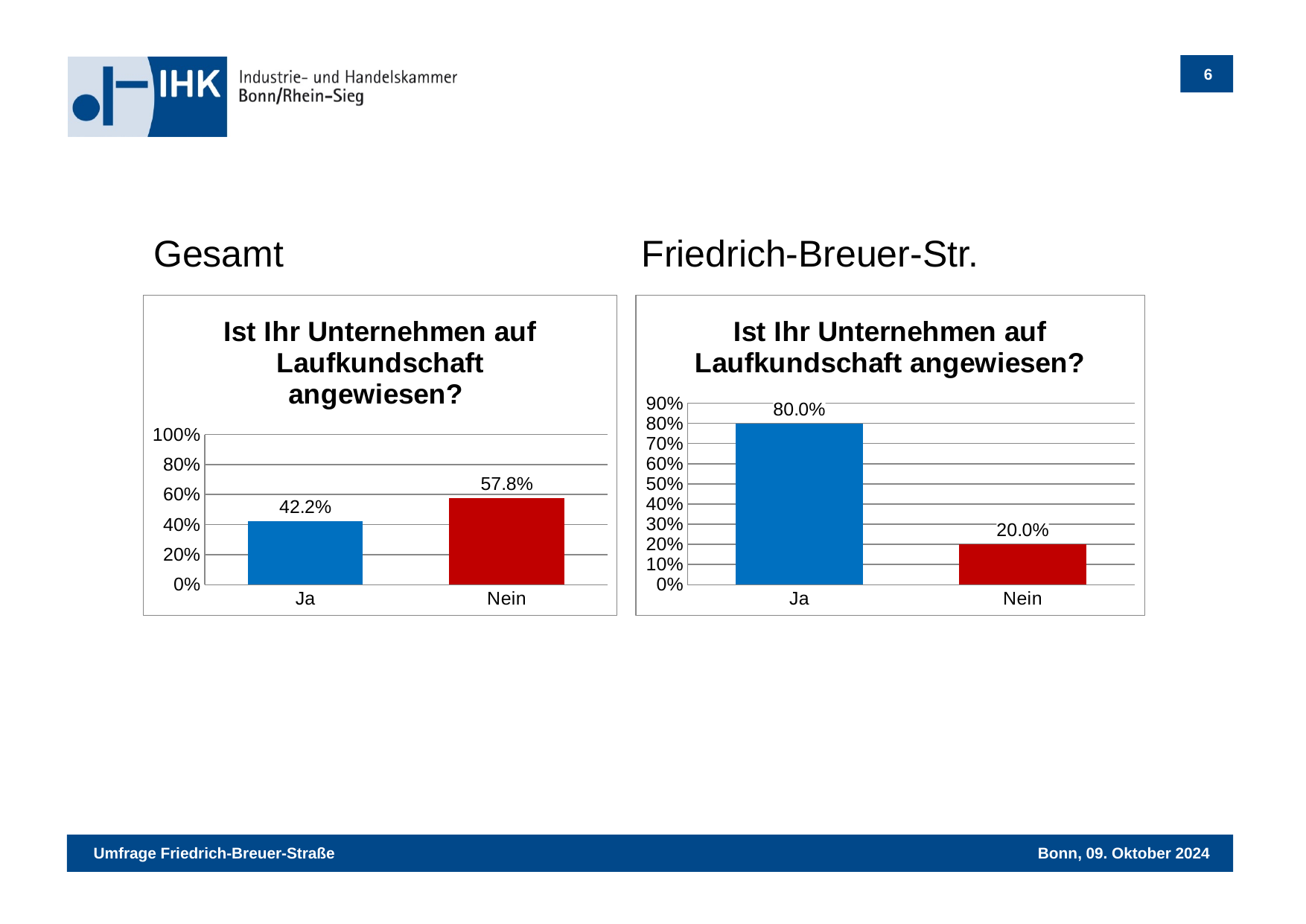
In the right chart (Friedrich-Breuer-Str.), what is the value for Nein? 20.0% What is the title of the right chart (Friedrich-Breuer-Str.)? Ist Ihr Unternehmen auf Laufkundschaft angewiesen? In the left chart (Gesamt), what is the value for Ja? 42.2% What kind of chart is the left chart (Gesamt)? Bar chart In the left chart (Gesamt), which is larger, the value for Ja or the value for Nein? Nein In the left chart (Gesamt), what is the value for Nein? 57.8% In the right chart (Friedrich-Breuer-Str.), what is the difference between the values for Ja and Nein? 60.0% How many categories are shown in the right chart (Friedrich-Breuer-Str.)? 2 In the right chart (Friedrich-Breuer-Str.), which category has the lowest value? Nein In the left chart (Gesamt), what is the difference between the values for Nein and Ja? 15.6% In the left chart (Gesamt), which category has the highest value? Nein In the right chart (Friedrich-Breuer-Str.), what is the value for Ja? 80.0%